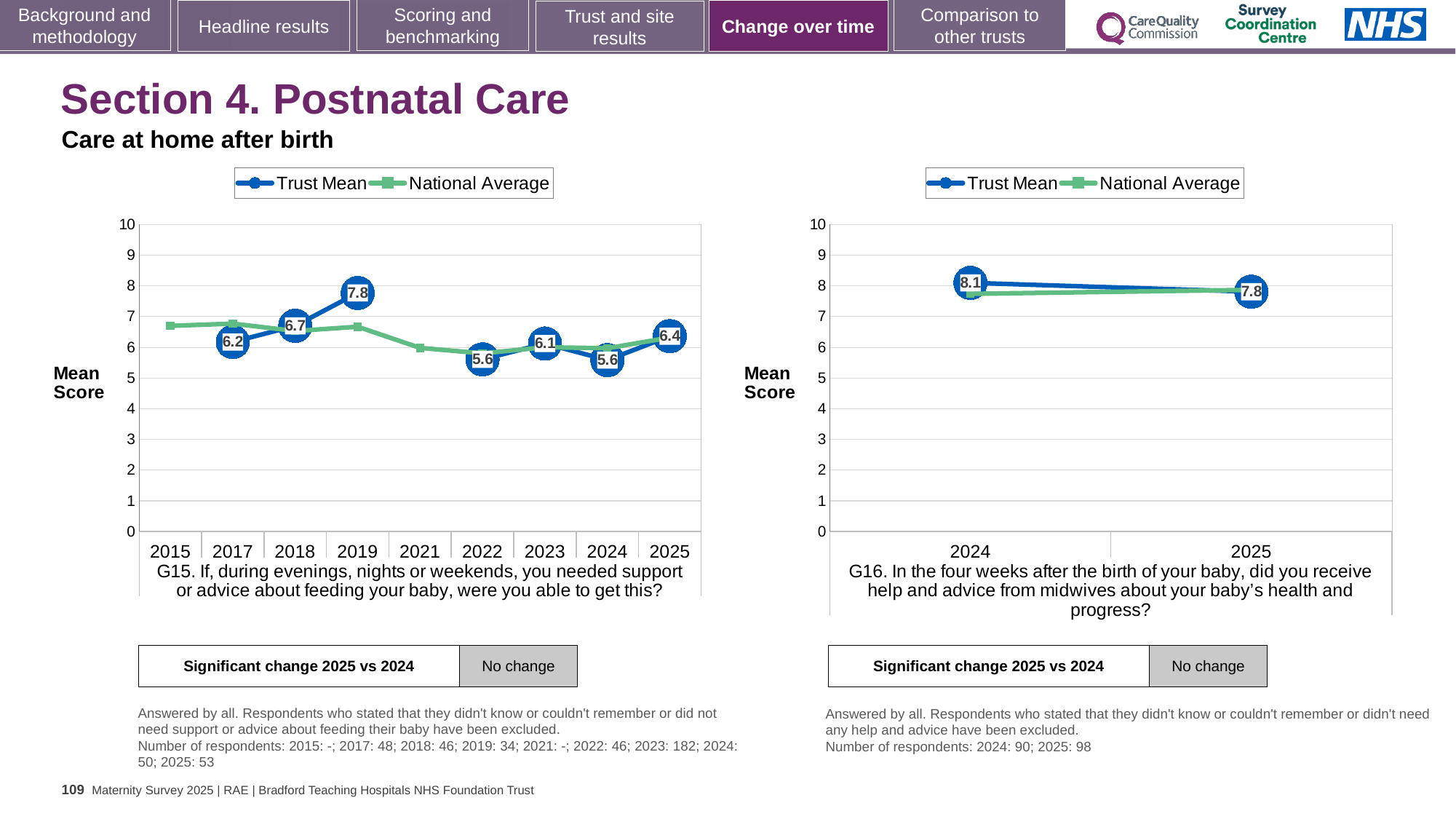
In the G15 chart on the left, what is the Trust Mean value for 2025? 6.4 What kind of chart is the G16 chart on the right? Line chart In the G15 chart on the left, which year has the highest Trust Mean value? 2019 How many series does the legend of the G16 chart on the right list? 2 In the G16 chart on the right, does the Trust Mean rise or fall from 2024 to 2025? Fall In the G15 chart on the left, what is the difference between the Trust Mean values for 2025 and 2024? 0.8 In the G16 chart on the right, what is the Trust Mean value for 2024? 8.1 In the G15 chart on the left, is the National Average value for 2015 greater or less than 6? greater In the G15 chart on the left, what is the Trust Mean value for 2019? 7.8 How many years are shown on the x axis of the G15 chart on the left? 9 In the G15 chart on the left, which is larger, the Trust Mean for 2018 or for 2019? 2019 In the G16 chart on the right, what is the difference between the Trust Mean values for 2024 and 2025? 0.3